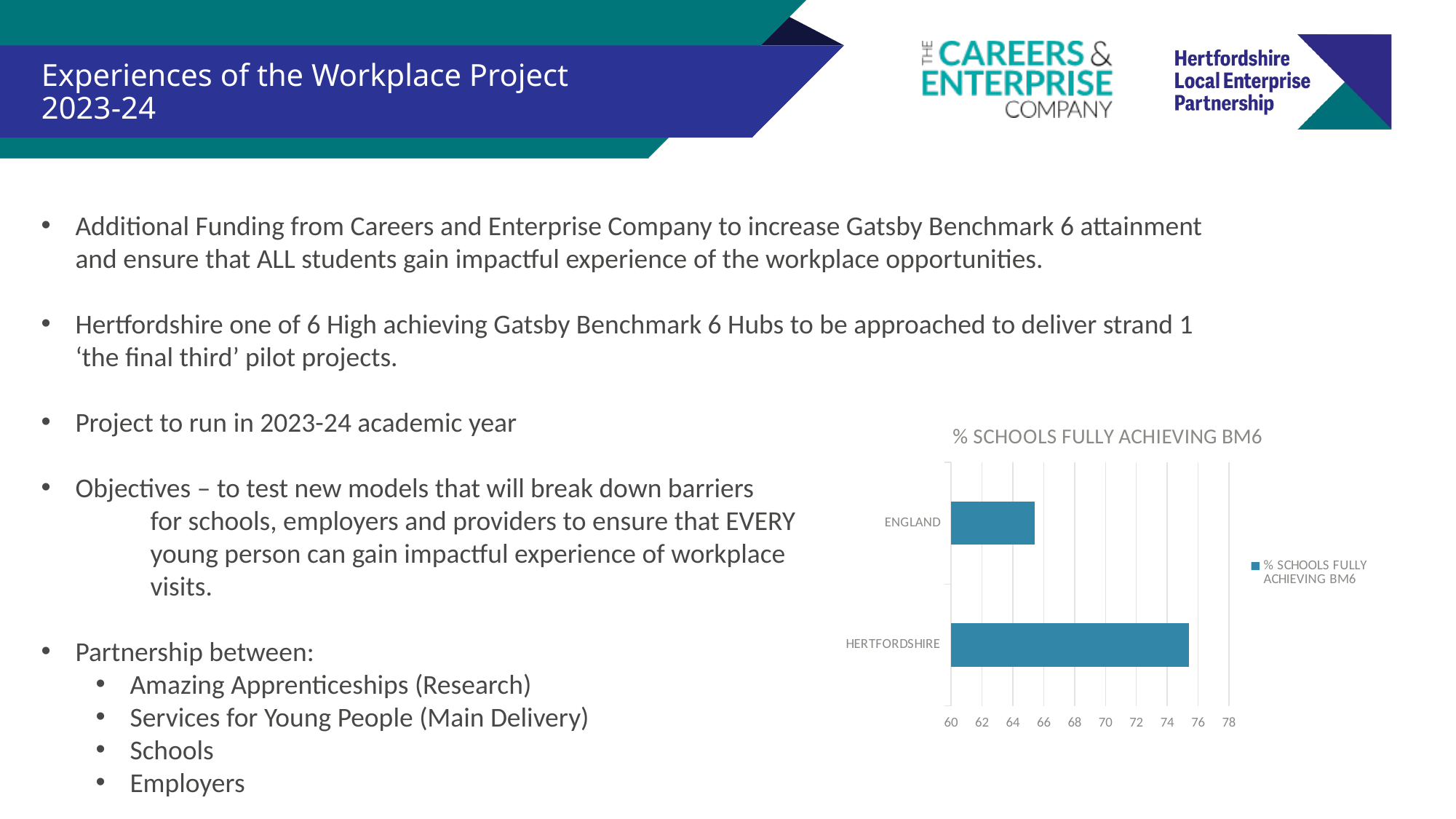
Which category has the highest value in the chart? HERTFORDSHIRE How many categories are plotted in the chart? 2 What is the title of the chart on the slide? % SCHOOLS FULLY ACHIEVING BM6 Which category has the lowest value in the chart? ENGLAND Is the value for HERTFORDSHIRE greater or less than 78? less Is the value for ENGLAND greater or less than 68? less Which has a larger value in the chart, ENGLAND or HERTFORDSHIRE? HERTFORDSHIRE Is the value for HERTFORDSHIRE greater or less than 72? greater How many series does the chart legend list? 1 What type of chart is shown on the slide? bar chart What is the name of the series shown in the chart legend? % SCHOOLS FULLY ACHIEVING BM6